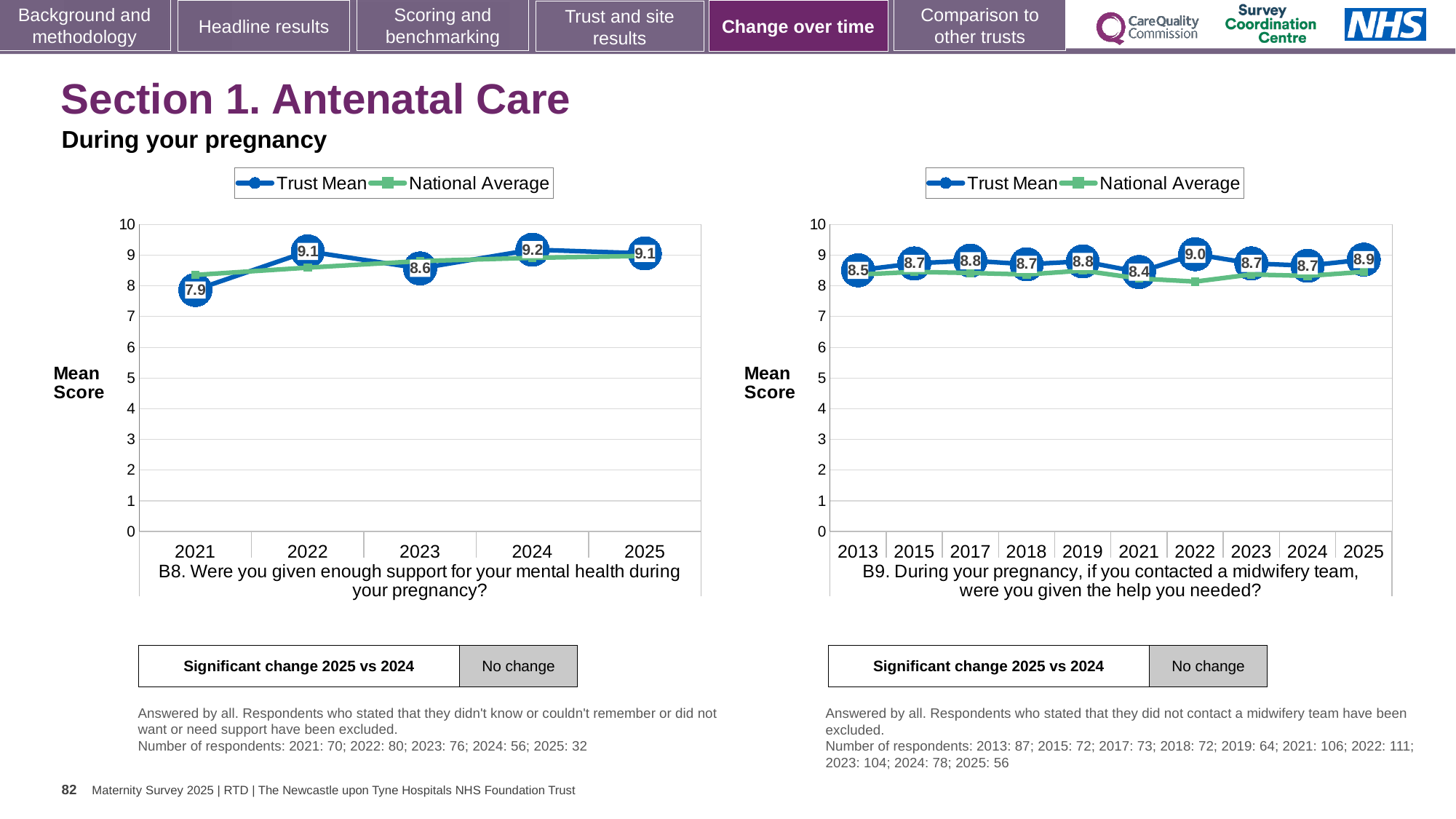
On the B8 chart (left), what is the Trust Mean for 2024? 9.2 On the B8 chart (left), which year has the lowest Trust Mean? 2021 How many series does the legend of the B8 chart (left) list? 2 On the B8 chart (left), how many years are shown on the x axis? 5 On the B8 chart (left), what is the Trust Mean for 2021? 7.9 On the B9 chart (right), is the Trust Mean for 2025 greater or less than the Trust Mean for 2024? greater On the B8 chart (left), what is the difference between the Trust Mean in 2024 and in 2021? 1.3 On the B9 chart (right), what is the Trust Mean for 2022? 9.0 On the B9 chart (right), what is the Trust Mean for 2021? 8.4 On the B9 chart (right), how many years are shown on the x axis? 10 On the B9 chart (right), which year has the highest Trust Mean? 2022 What kind of chart is the B9 chart (right)? Line chart